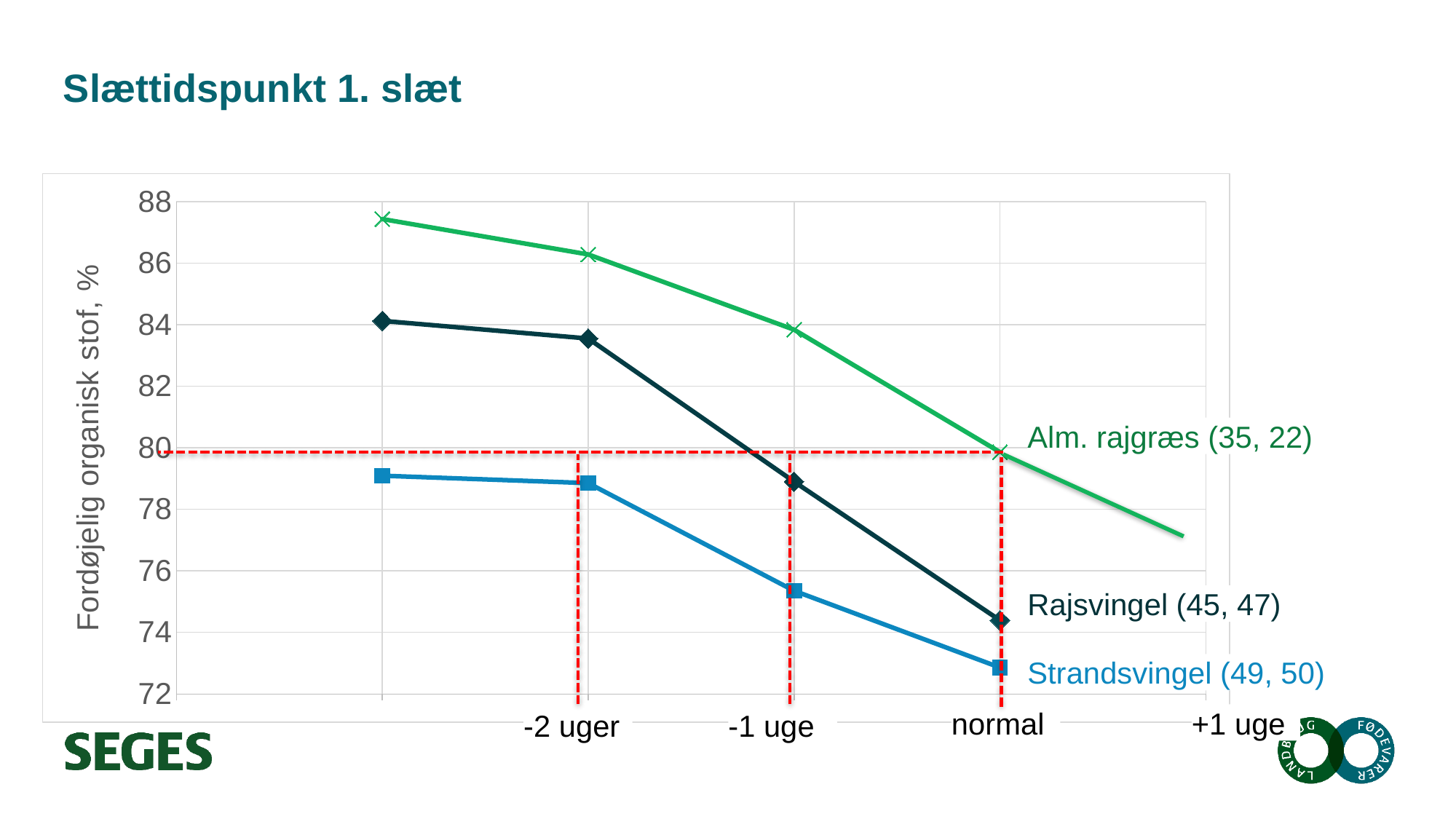
At '-1 uge', which is larger: the value for Alm. rajgræs or the value for Rajsvingel? Alm. rajgræs Which series has the highest value at 'normal'? Alm. rajgræs Is the value for Alm. rajgræs at '-2 uger' greater or less than 84? greater How many series are plotted on the chart? 3 Do the values for Rajsvingel rise or fall from left to right along the x axis? fall What is the label of the y axis? Fordøjelig organisk stof, % What kind of chart is shown on the slide? line chart Is the value for Rajsvingel at 'normal' greater or less than 76? less Is the value for Strandsvingel at '-1 uge' greater or less than 76? less How many data points are plotted for the Strandsvingel series? 4 Which series has the lowest value at '-1 uge'? Strandsvingel